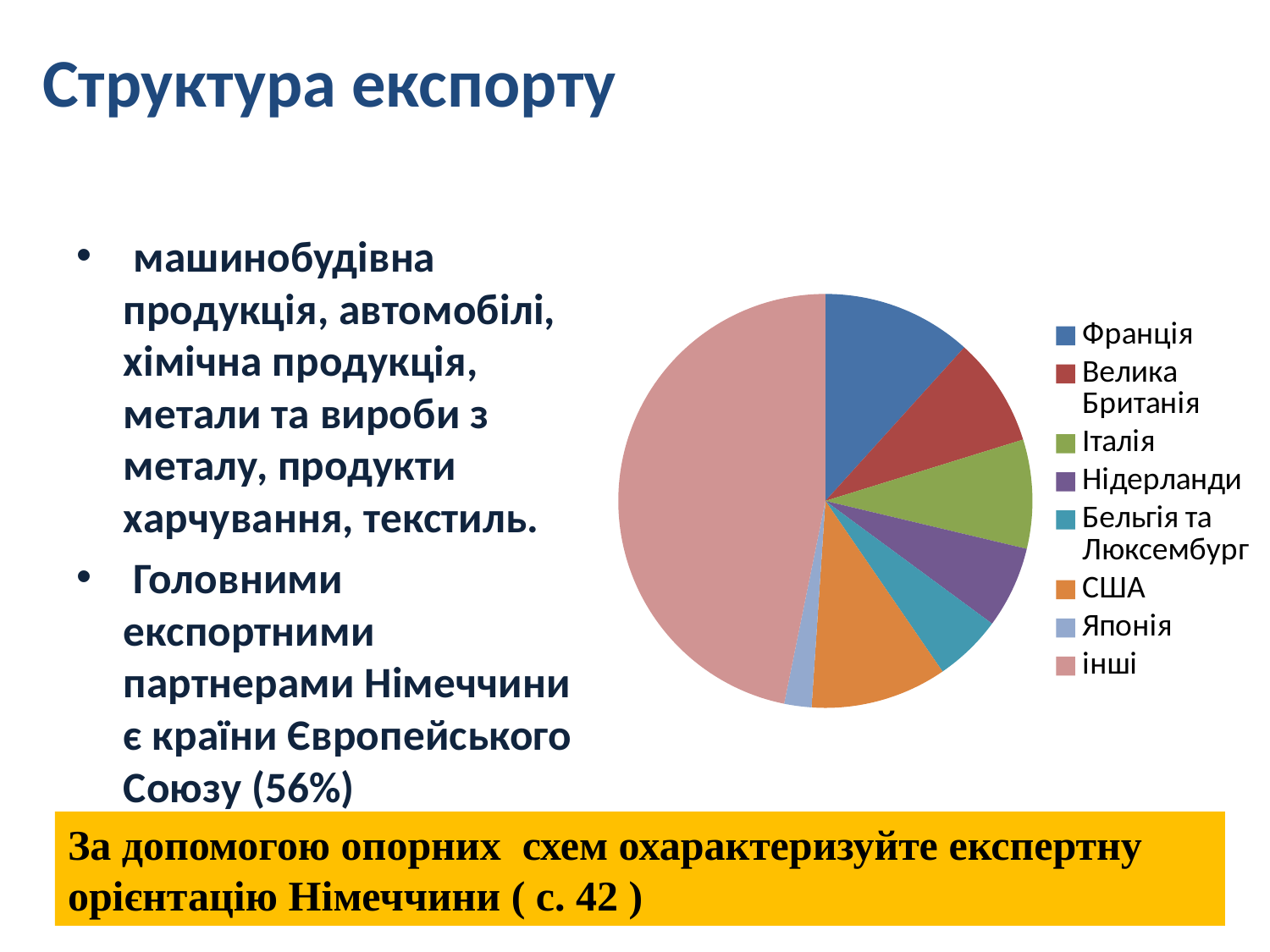
Which slice is larger, інші or Італія? інші Which category is listed last in the legend of the pie chart? інші Which slice is larger, Франція or Японія? Франція What kind of chart is shown on the slide? pie chart Which slice is larger, Франція or Бельгія та Люксембург? Франція Which category has the largest slice of the pie chart? інші Which category has the smallest slice of the pie chart? Японія How many categories does the pie chart show? 8 Which category is listed first in the legend of the pie chart? Франція